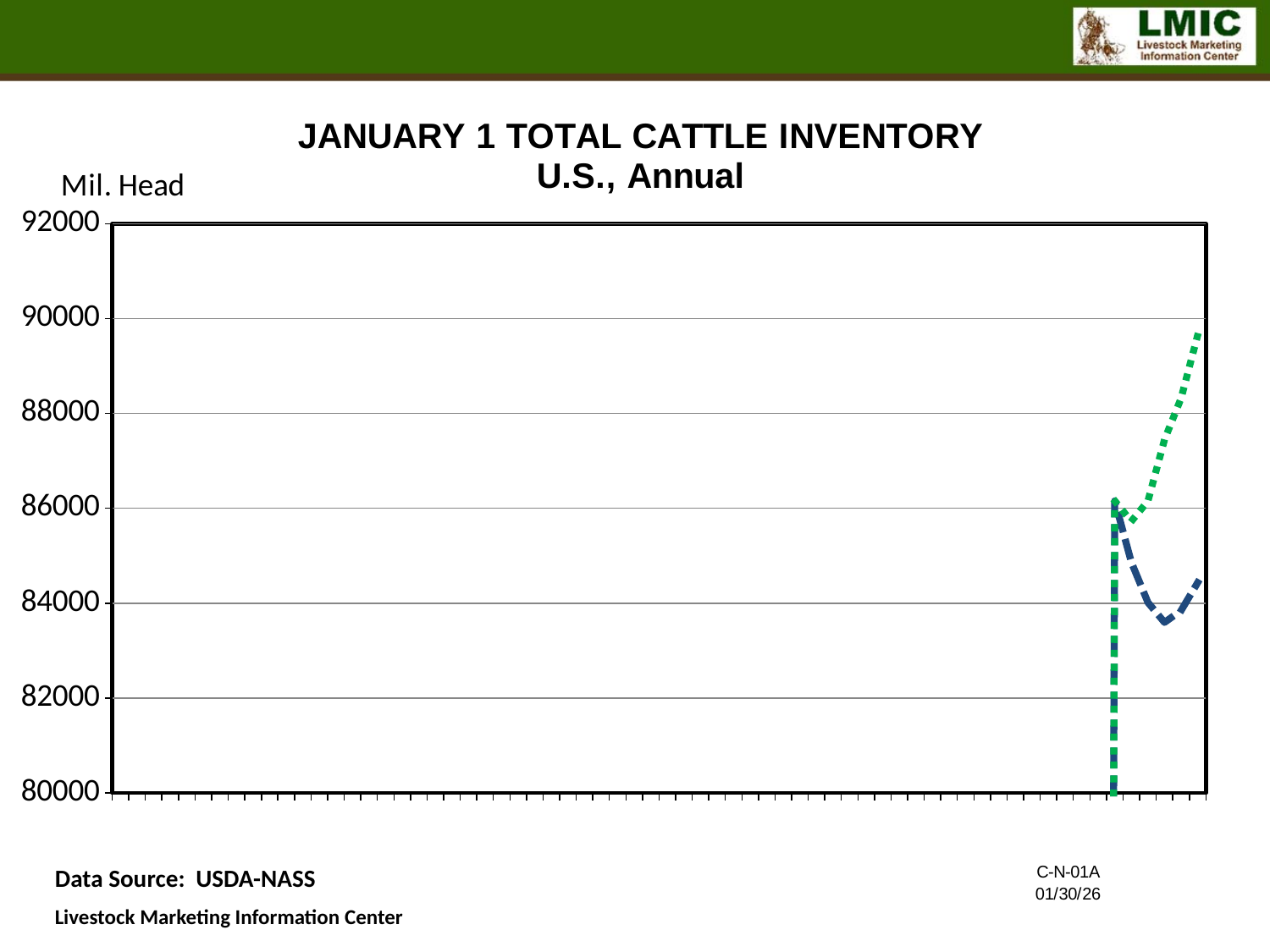
At the right edge of the chart, which line is higher, the green dotted line or the blue dashed line? green dotted line What kind of chart is shown on the slide? line chart What is the highest value shown on the vertical axis? 92000 What is the title of the chart? JANUARY 1 TOTAL CATTLE INVENTORY U.S., Annual Is the lowest point of the blue dashed line greater or less than 86000? less Does the green dotted line rise or fall as it moves to the right? rise Is the highest point of the green dotted line greater or less than 90000? less What is the lowest value shown on the vertical axis? 80000 Is the value at the right end of the blue dashed line greater or less than 82000? greater What unit label is shown on the vertical axis of the chart? Mil. Head How many lines are plotted on the chart? 2